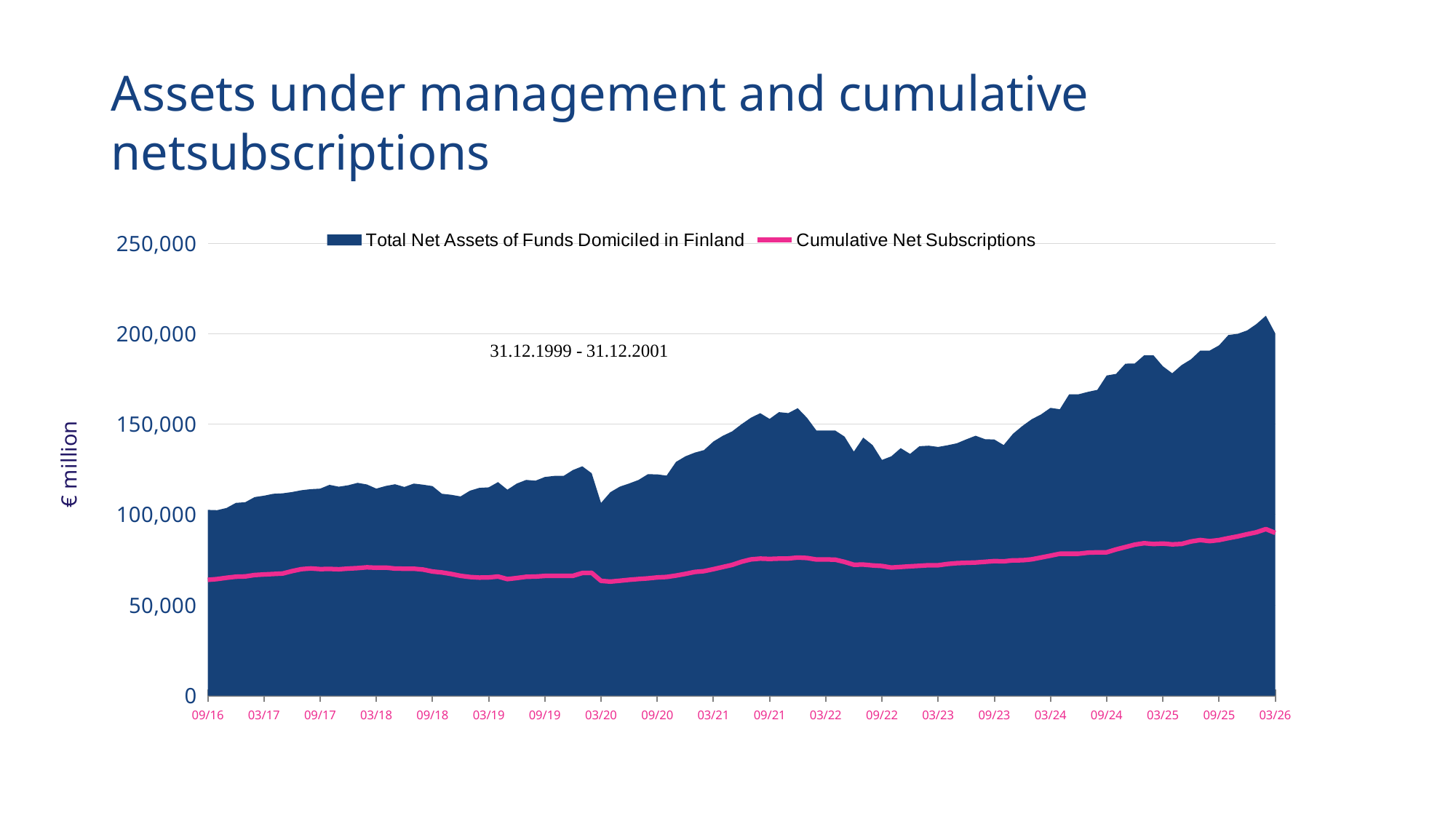
Does Total Net Assets of Funds Domiciled in Finland generally rise or fall from 09/16 to 03/26? Rise What is the label on the vertical axis of the chart? € million What kind of chart is shown on the slide? Area chart with a line series What colour is the Cumulative Net Subscriptions series in the chart? Pink Is the value of Cumulative Net Subscriptions at 03/26 greater or less than 100,000? less How many series does the chart legend list? 2 Is Total Net Assets of Funds Domiciled in Finland larger at 09/16 or at 03/26? 03/26 Is the value of Total Net Assets of Funds Domiciled in Finland at 09/25 greater or less than 200,000? less Is the value of Cumulative Net Subscriptions at 09/16 greater or less than 50,000? greater Which is larger at 03/24: Total Net Assets of Funds Domiciled in Finland or Cumulative Net Subscriptions? Total Net Assets of Funds Domiciled in Finland How many date labels are shown on the x axis of the chart? 20